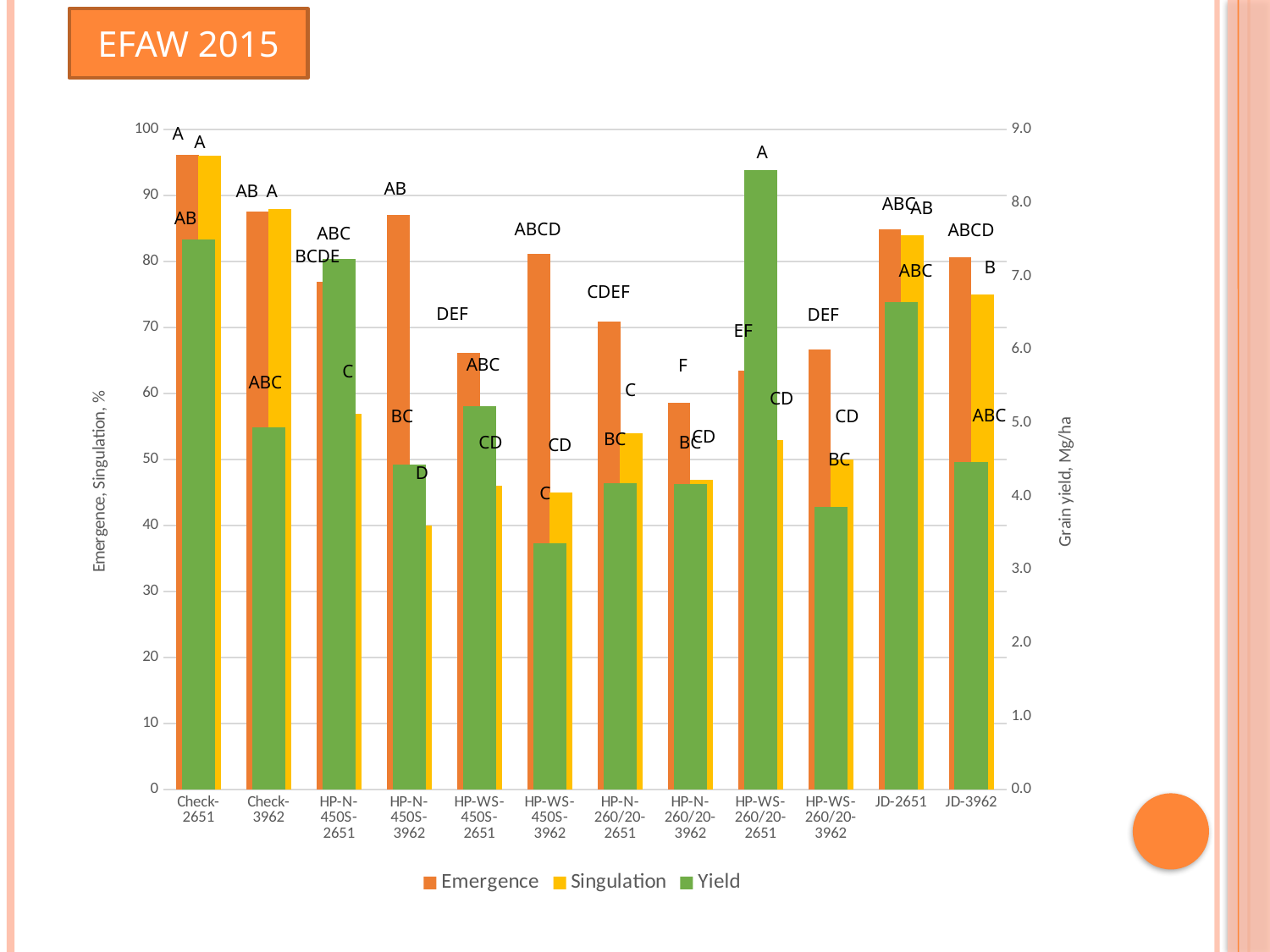
Is the Emergence value for HP-N-450S-3962 greater or less than 80? greater Which category has the highest Emergence value? Check-2651 What kind of chart is shown on the slide? bar chart Which has the larger Singulation value, HP-N-450S-2651 or HP-WS-450S-2651? HP-N-450S-2651 Is the Singulation value for HP-N-450S-3962 greater or less than 50? less Which category has the lowest Singulation value? HP-N-450S-3962 What is the title of the right-hand vertical axis? Grain yield, Mg/ha Which category has the lowest Yield value? HP-WS-450S-3962 How many treatment categories are shown along the x axis? 12 Which category has the highest Yield value? HP-WS-260/20-2651 Is the Yield value for HP-WS-260/20-2651 greater or less than 8.0 Mg/ha? greater How many series does the legend list? 3